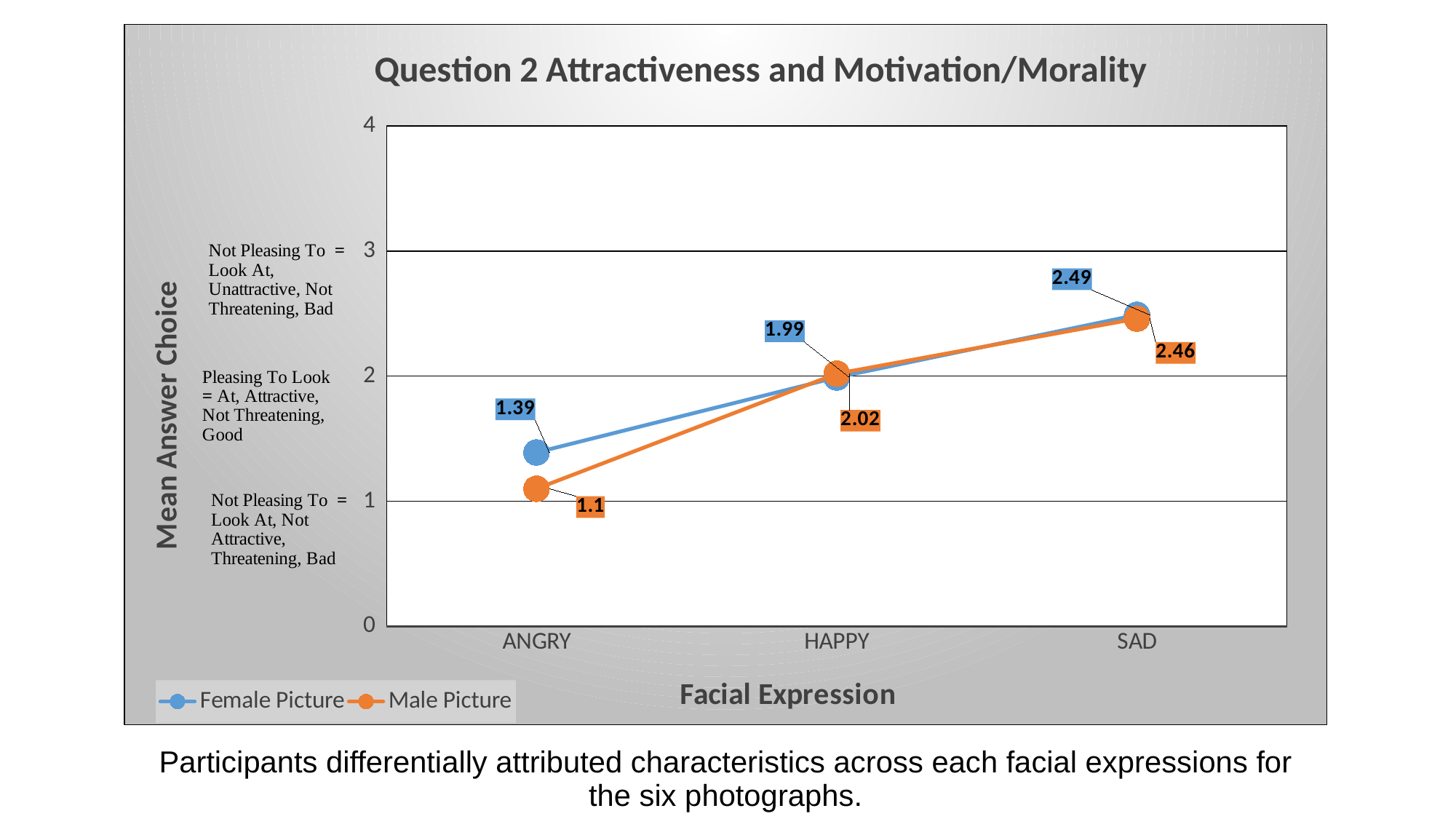
How many facial expression categories are shown on the x axis? 3 What is the value for Male Picture at HAPPY? 2.02 Do the Female Picture values rise or fall from ANGRY to SAD? Rise What is the value for Female Picture at ANGRY? 1.39 What kind of chart is this? Line chart What is the value for Male Picture at SAD? 2.46 At ANGRY, which series has the larger value, Female Picture or Male Picture? Female Picture What is the difference between the Female Picture and Male Picture values at ANGRY? 0.29 Which facial expression has the highest value for Female Picture? SAD How many series does the legend list? 2 What is the value for Female Picture at SAD? 2.49 Which facial expression has the lowest value for Male Picture? ANGRY